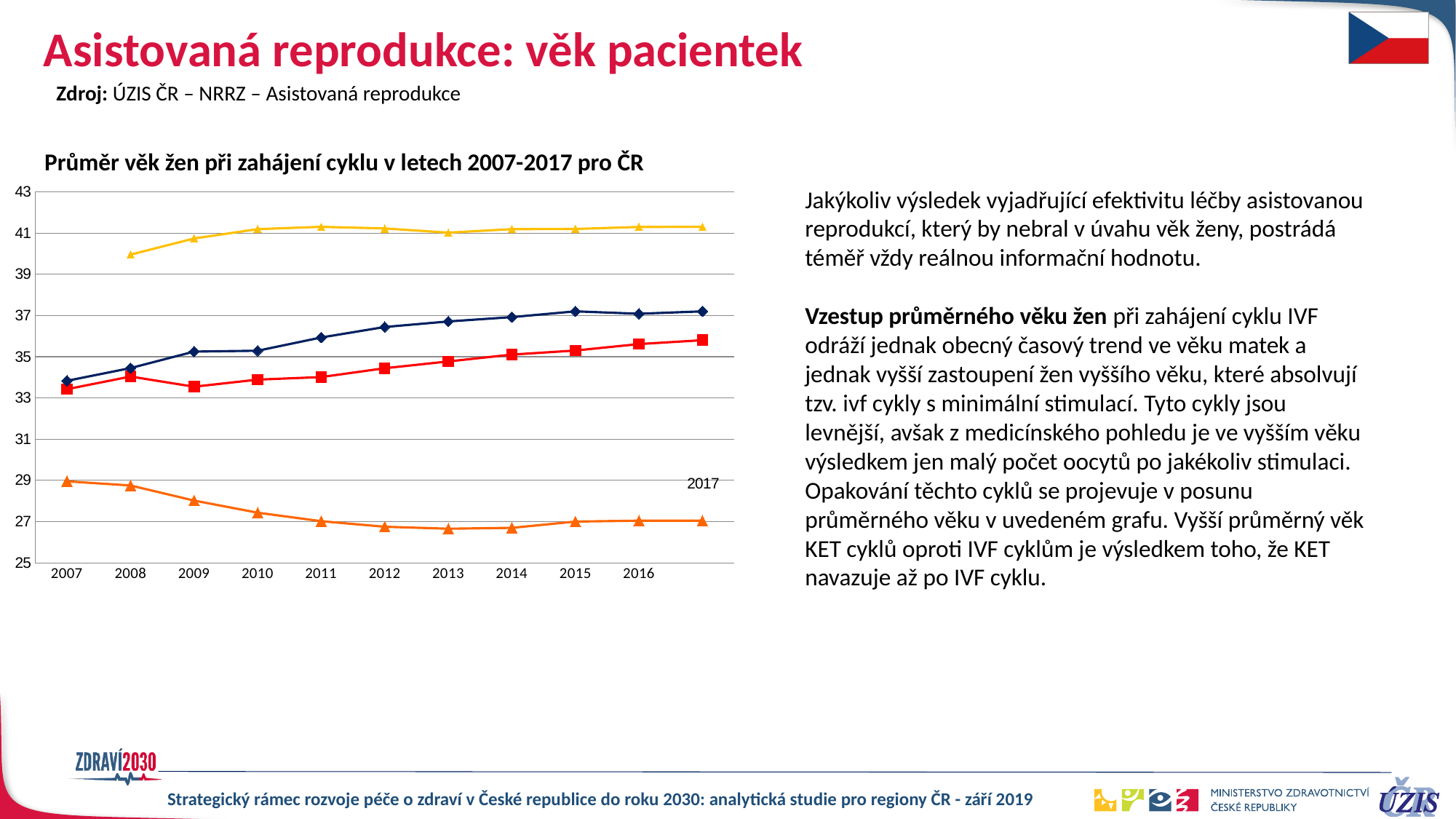
Is the value of the red line in 2017 greater or less than 35? greater In 2017, which is higher: the dark blue line or the red line? the dark blue line Does the dark blue line rise or fall from 2007 to 2017? rise Which line lies highest on the chart across the years? the yellow line Is the value of the dark blue line in 2012 greater or less than 37? less What kind of chart is shown on the slide? line chart How many lines are plotted on the chart? 4 Which line lies lowest on the chart across the years? the orange line Does the orange line rise or fall from 2007 to 2013? fall Is the value of the yellow line in 2008 greater or less than 41? less What is the title of the chart? Průměr věk žen při zahájení cyklu v letech 2007-2017 pro ČR